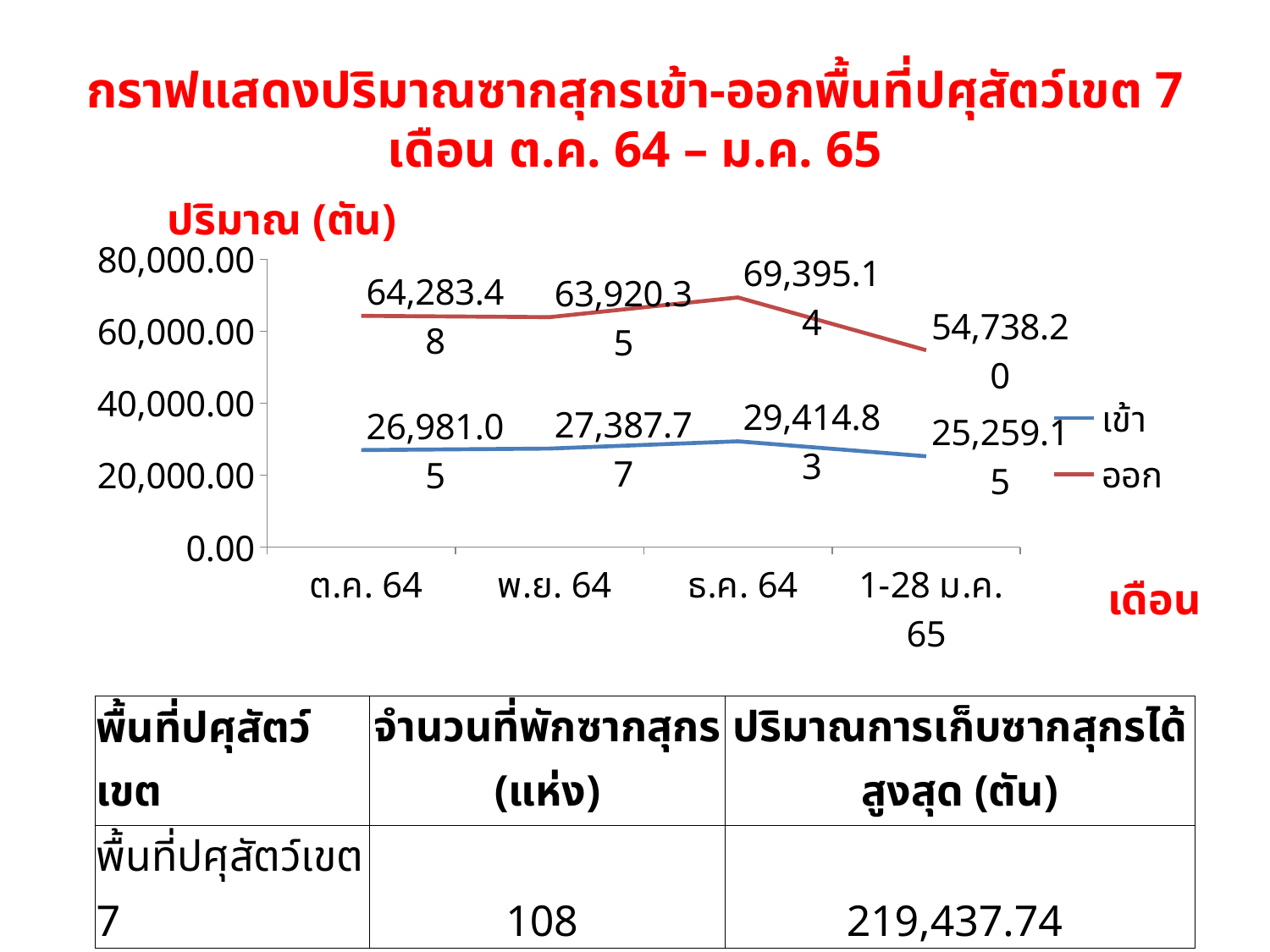
What is the value of the เข้า series for พ.ย. 64? 27,387.77 Is the ออก value for 1-28 ม.ค. 65 greater or less than 60,000.00? less What is the value of the ออก series for ธ.ค. 64? 69,395.14 In which month is the ออก series highest? ธ.ค. 64 What is the difference between the ออก and เข้า values for ธ.ค. 64? 39,980.31 What kind of chart is shown on the slide? line chart Which series has the larger value in ต.ค. 64, เข้า or ออก? ออก In which month is the เข้า series lowest? 1-28 ม.ค. 65 What is the value of the เข้า series for ต.ค. 64? 26,981.05 What is the value of the ออก series for 1-28 ม.ค. 65? 54,738.20 How many series does the legend list? 2 How many months are shown on the x axis? 4